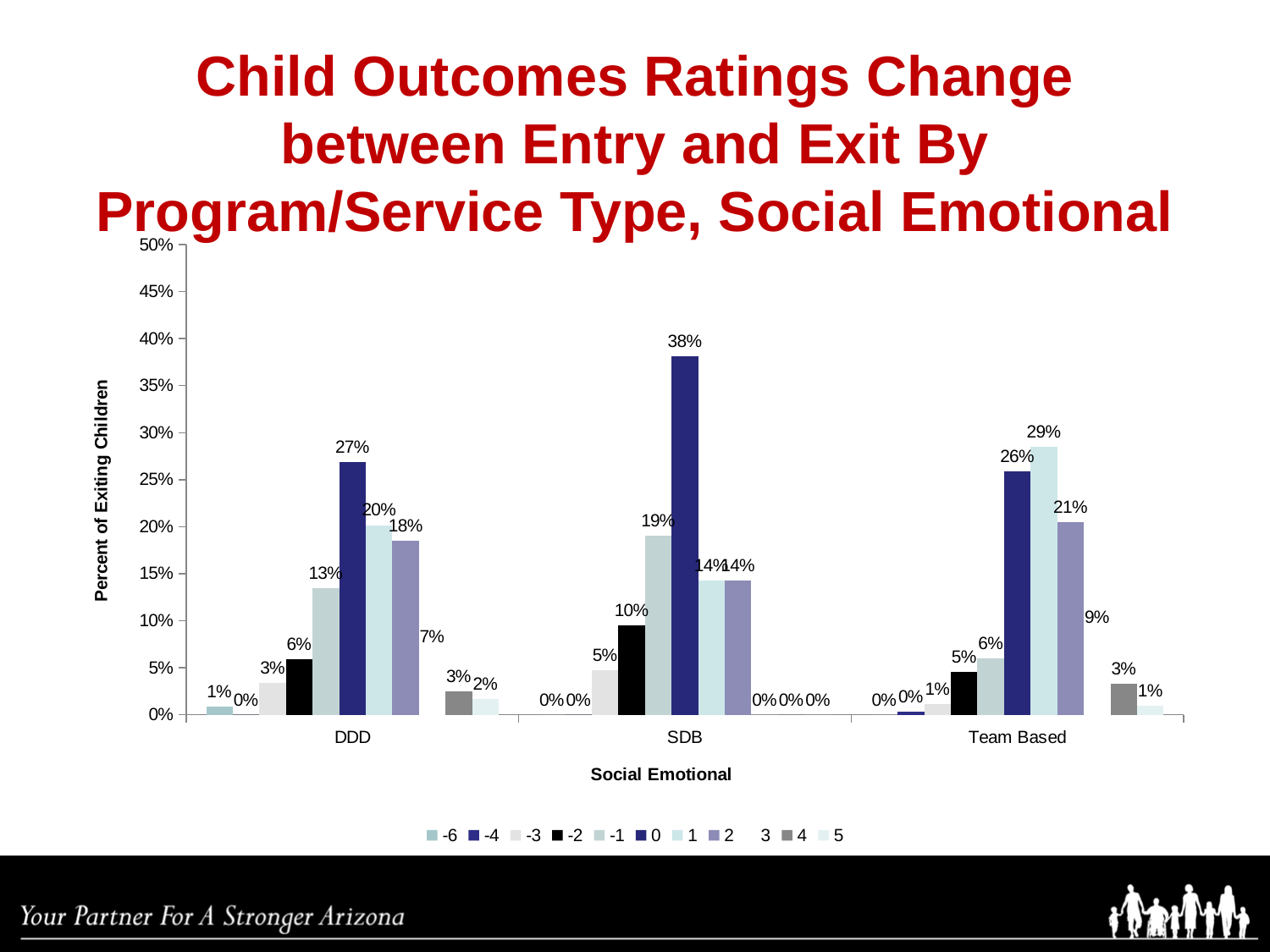
Which category contains the tallest bar in the chart? SDB What is the value for series -1 in the DDD category? 13% What is the value for series -2 in the SDB category? 10% In the Team Based category, which is larger: the value for series 0 or the value for series 1? 1 What kind of chart is shown on the slide? bar chart What is the value for series 1 in the Team Based category? 29% In the DDD category, what is the difference between the value for series 0 and the value for series 1? 7% What is the title of the y axis? Percent of Exiting Children How many series does the legend list? 11 How many program/service type categories are shown on the x axis? 3 What is the value for series 0 in the SDB category? 38% Which series has the highest value in the SDB category? 0